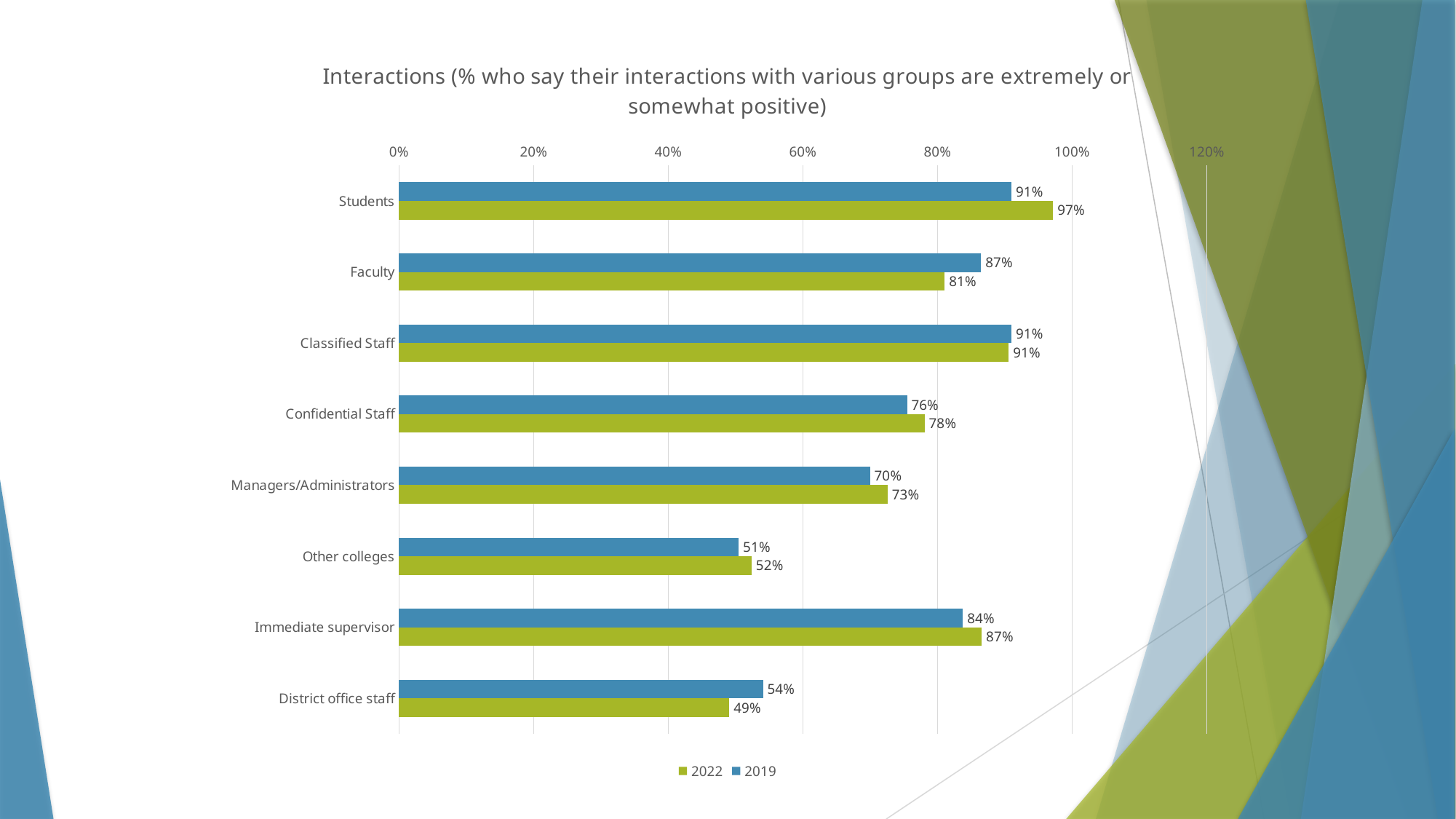
What is the difference between the 2019 and 2022 values for District office staff? 5% How many series does the legend list? 2 Which category has the highest 2022 value? Students Which category has the lowest 2019 value? Other colleges What kind of chart is shown on the slide? Bar chart What is the difference between the 2022 and 2019 values for Students? 6% What is the 2022 value for Students? 97% What is the 2022 value for District office staff? 49% How many categories are shown on the chart? 8 What is the 2019 value for Faculty? 87% Which series is shown in green? 2022 Which is larger for Faculty, the 2019 value or the 2022 value? 2019